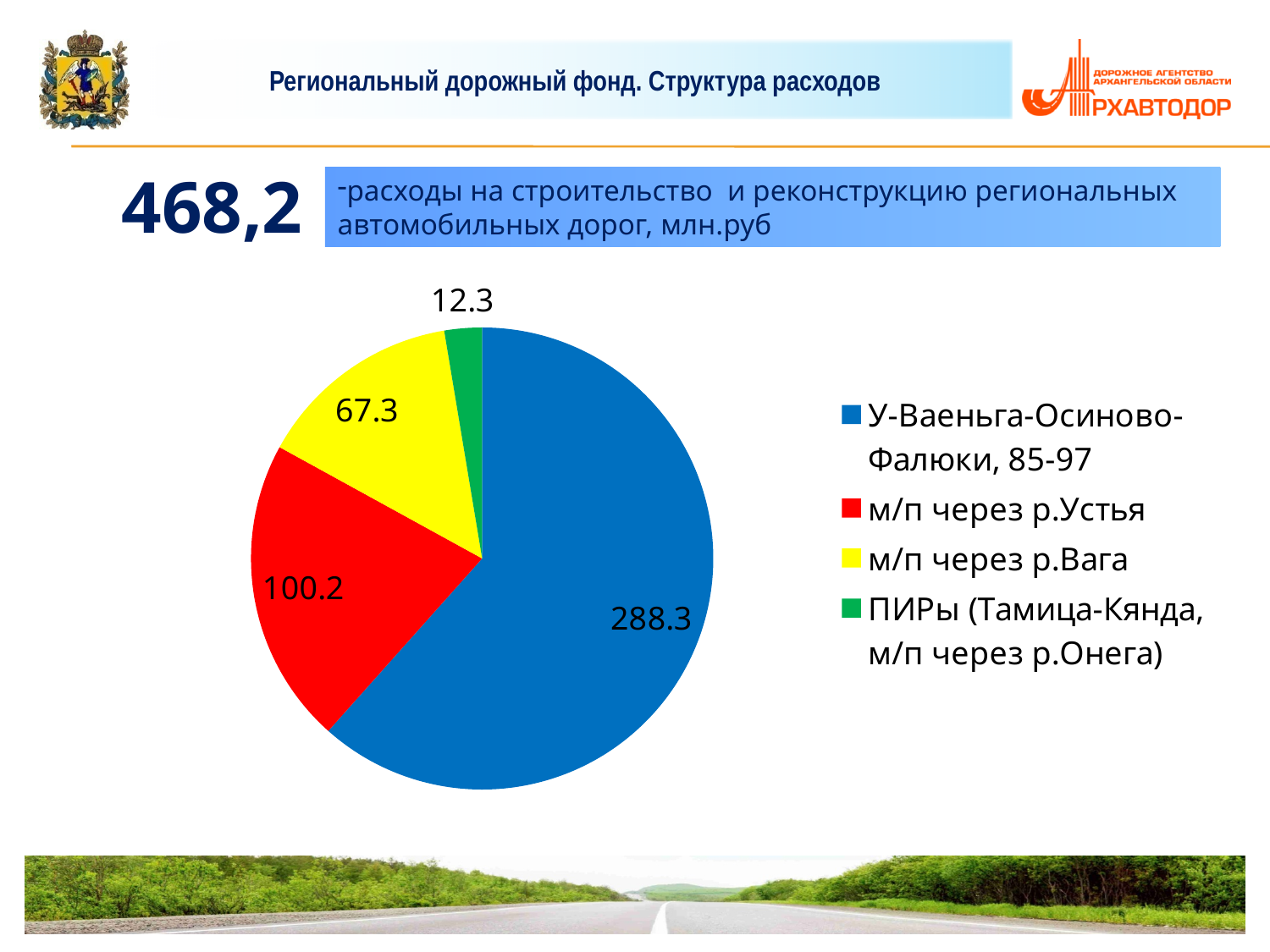
What is the value for ПИРы (Тамица-Кянда, м/п через р.Онега)? 12.3 Which category has the smallest slice of the pie? ПИРы (Тамица-Кянда, м/п через р.Онега) What colour is the slice for м/п через р.Устья? red What is the value for м/п через р.Вага? 67.3 Which is larger, the value for м/п через р.Вага or the value for ПИРы (Тамица-Кянда, м/п через р.Онега)? м/п через р.Вага Which category has the largest slice of the pie? У-Ваеньга-Осиново-Фалюки, 85-97 What is the value for м/п через р.Устья? 100.2 What type of chart is shown on the slide? pie chart What is the value for У-Ваеньга-Осиново-Фалюки, 85-97? 288.3 What is the difference between the values for м/п через р.Устья and м/п через р.Вага? 32.9 How many categories does the pie chart have? 4 What is the difference between the values for У-Ваеньга-Осиново-Фалюки, 85-97 and м/п через р.Устья? 188.1